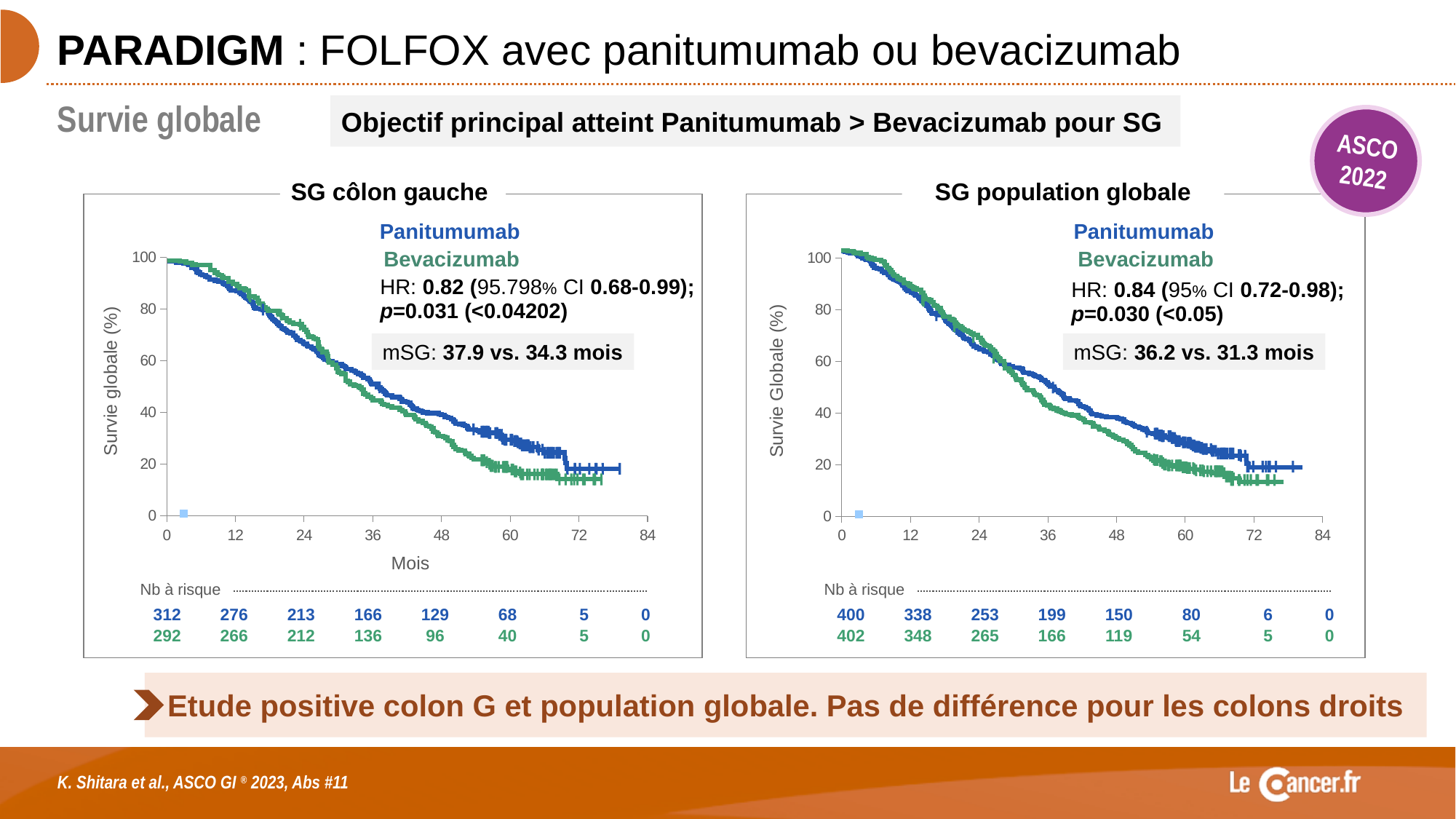
In the 'SG population globale' chart, how many patients are at risk in the panitumumab arm at month 0? 400 In the 'SG côlon gauche' chart, what is the p-value shown? p=0.031 In the 'SG population globale' chart, what is the hazard ratio (HR) shown? 0.84 In the 'SG côlon gauche' chart, how many patients are at risk in the bevacizumab arm at month 36? 136 In the 'SG côlon gauche' chart, which arm has more patients at risk at month 48: panitumumab (129) or bevacizumab (96)? Panitumumab In the 'SG population globale' chart, what is the difference in median overall survival between panitumumab (36.2 mois) and bevacizumab (31.3 mois)? 4.9 mois In the 'SG côlon gauche' chart, do the survival curves rise or fall as months increase along the x axis? Fall How many treatment arms (series) are plotted in the 'SG côlon gauche' chart? 2 In the 'SG côlon gauche' chart, what is the median overall survival (mSG) for panitumumab vs. bevacizumab? 37.9 vs. 34.3 mois In the 'SG population globale' chart, is the survival probability for the bevacizumab curve at month 60 greater or less than 40%? less What is the label of the y axis in the 'SG côlon gauche' chart? Survie globale (%) What kind of chart is the 'SG population globale' chart? Line chart (Kaplan-Meier survival curve)